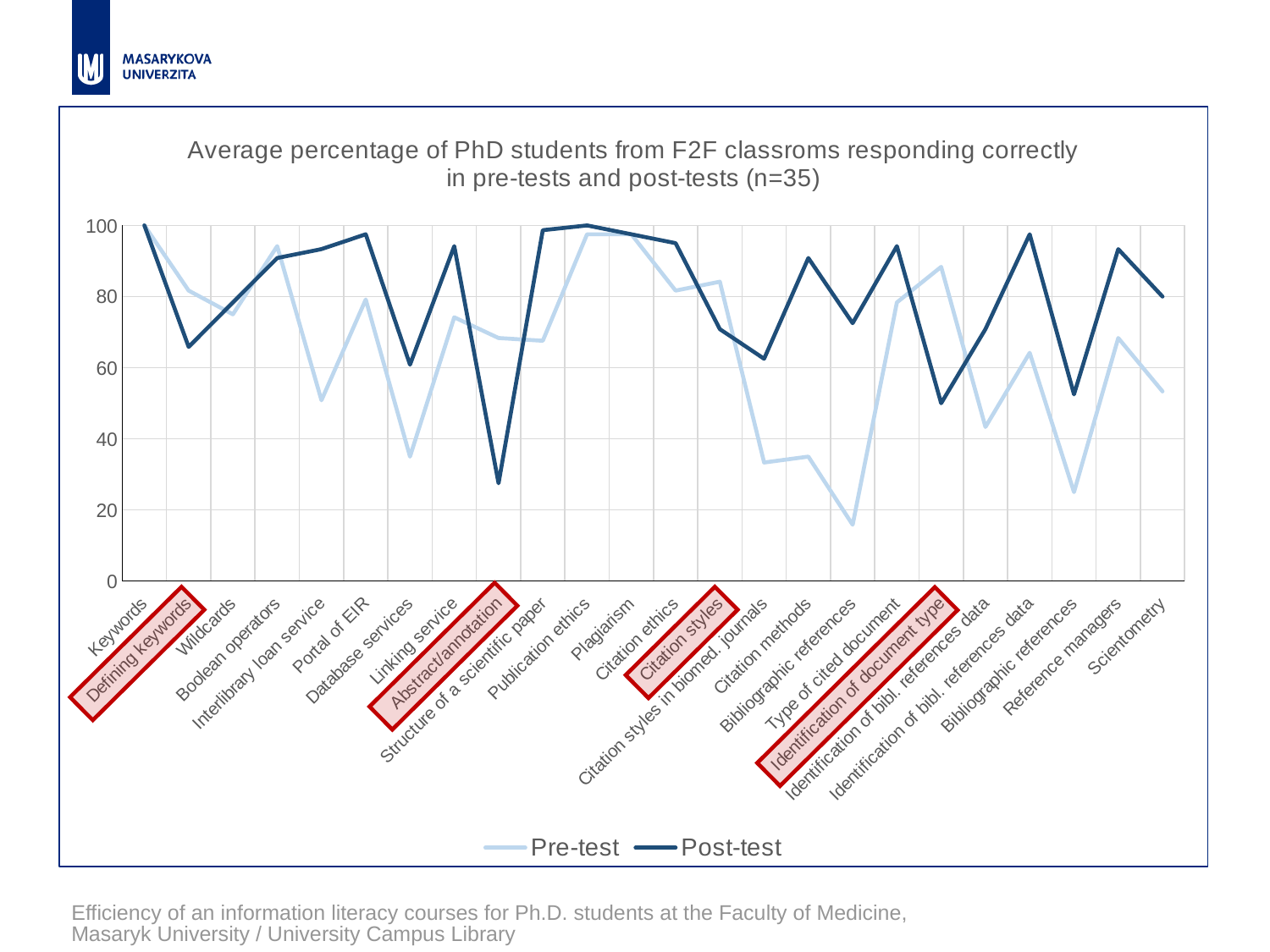
Which category has the lowest Post-test value? Abstract/annotation Is the Pre-test value for Database services greater or less than 40? less How many series does the legend list? 2 Is the Post-test value for Abstract/annotation greater or less than 40? less What is the Post-test value for Keywords? 100 What are the two series named in the legend? Pre-test and Post-test Is the Pre-test value for the first 'Bibliographic references' category greater or less than 20? less For Abstract/annotation, which is larger: the Pre-test value or the Post-test value? Pre-test What kind of chart is shown on the slide? Line chart What is the Pre-test value for Keywords? 100 How many categories are plotted along the x axis? 24 What is the sample size (n) stated in the chart title? n=35